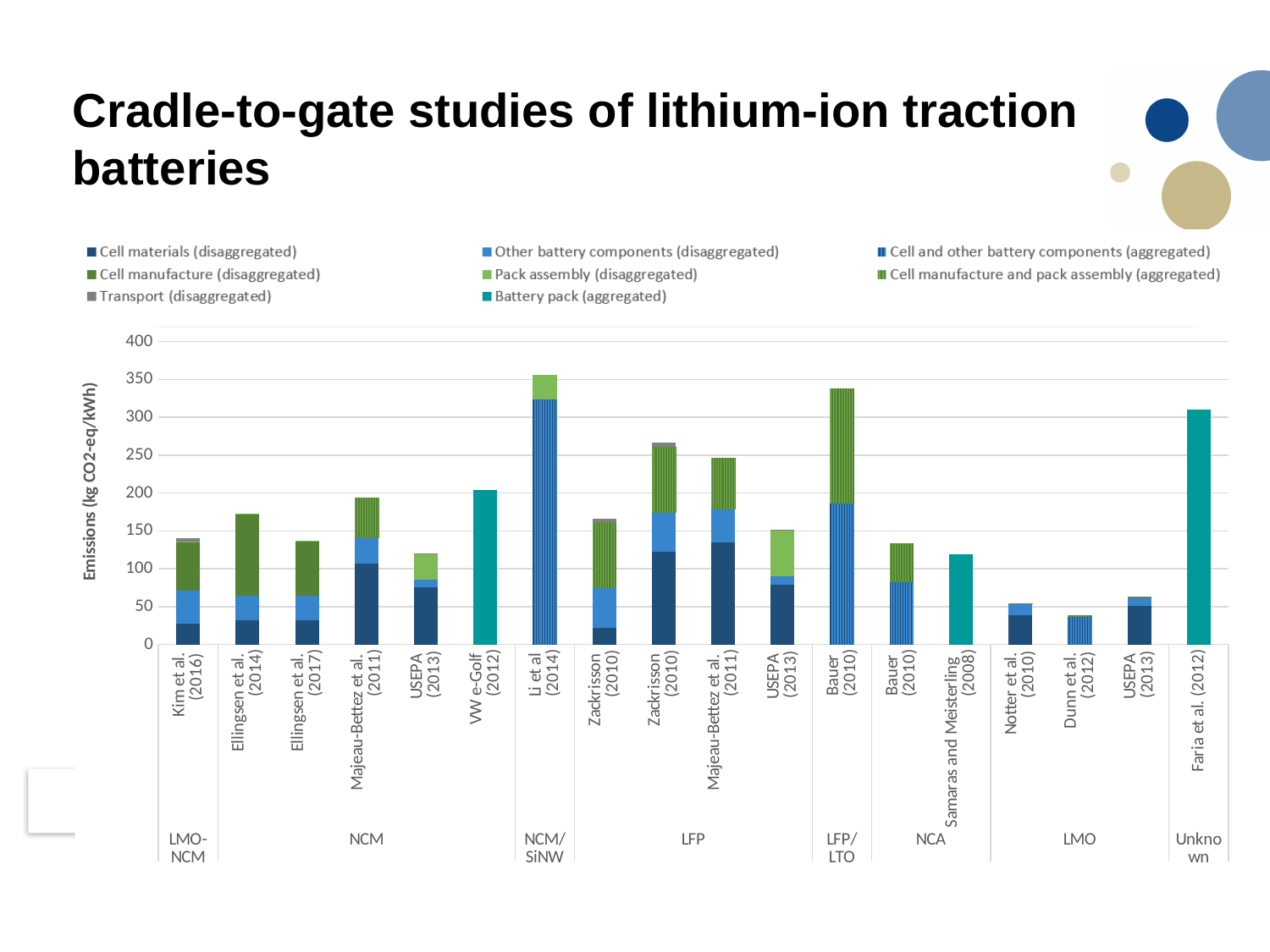
How many studies (bars) are plotted in the chart? 18 What is the label of the y-axis? Emissions (kg CO2-eq/kWh) Which has higher total emissions, Ellingsen et al. (2014) or Ellingsen et al. (2017)? Ellingsen et al. (2014) Is the value for Samaras and Meisterling (2008) greater or less than 100 kg CO2-eq/kWh? greater Which study has the lowest total emissions in the chart? Dunn et al. (2012) Which study has the highest total emissions in the chart? Li et al (2014) Is the value for Faria et al. (2012) greater or less than 300 kg CO2-eq/kWh? greater Which has higher total emissions, Majeau-Bettez et al. (2011) in the NCM group or Majeau-Bettez et al. (2011) in the LFP group? Majeau-Bettez et al. (2011) in the LFP group What kind of chart is shown on the slide? Stacked bar chart Is the value for Notter et al. (2010) greater or less than 100 kg CO2-eq/kWh? less How many series does the legend list? 8